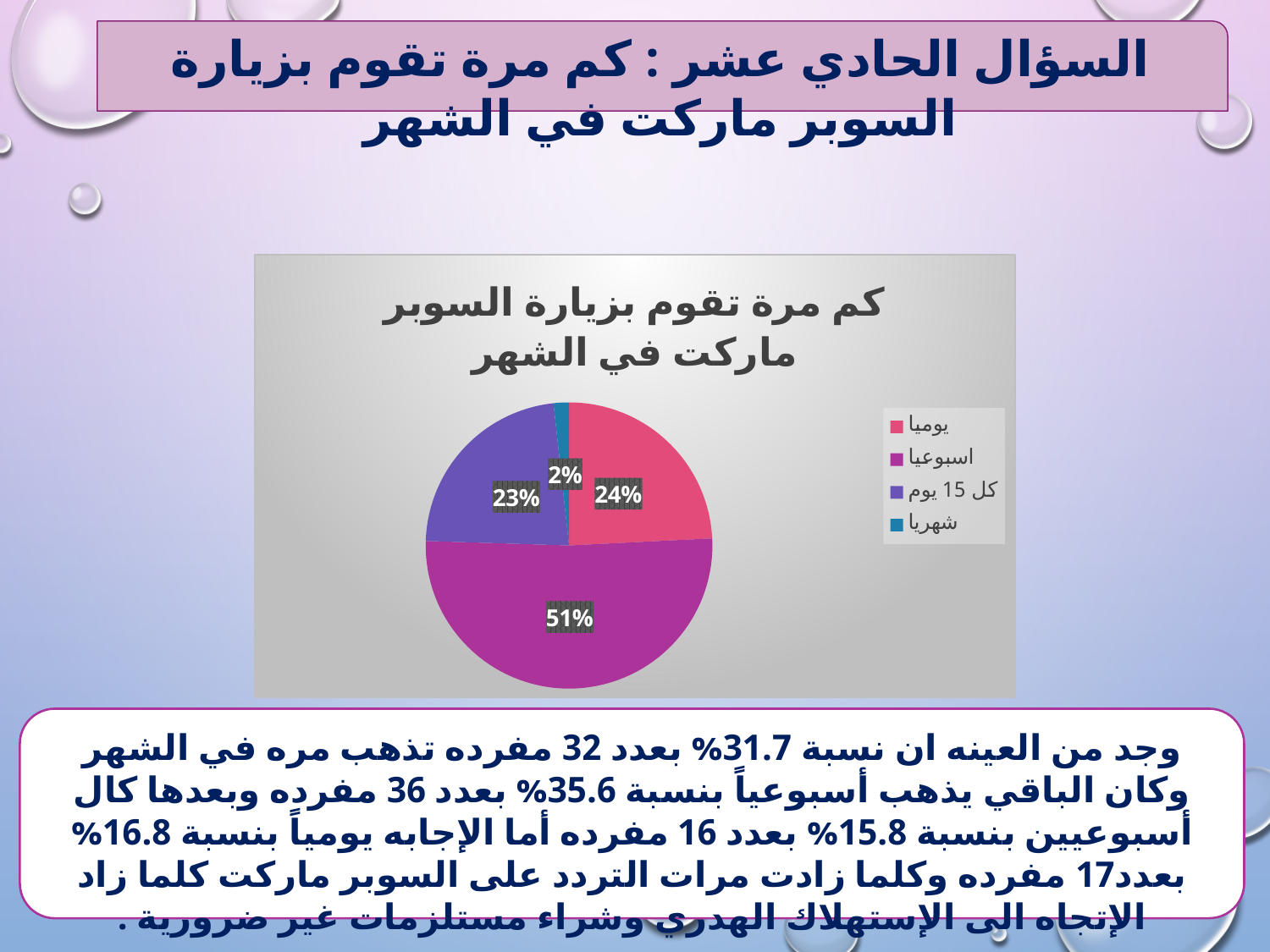
Which category has the largest share of the pie? اسبوعيا What percentage is shown for اسبوعيا? 51% What is the difference in percentage points between اسبوعيا and يوميا? 27 How many entries does the chart legend list? 4 What is the title of the chart? كم مرة تقوم بزيارة السوبر ماركت في الشهر Which colour represents شهريا in the pie chart? blue How many slices does the pie chart have? 4 What kind of chart is shown on the slide? pie chart What percentage is shown for شهريا? 2% Which category has the smallest share of the pie? شهريا What percentage is shown for يوميا? 24% What percentage is shown for كل 15 يوم? 23%